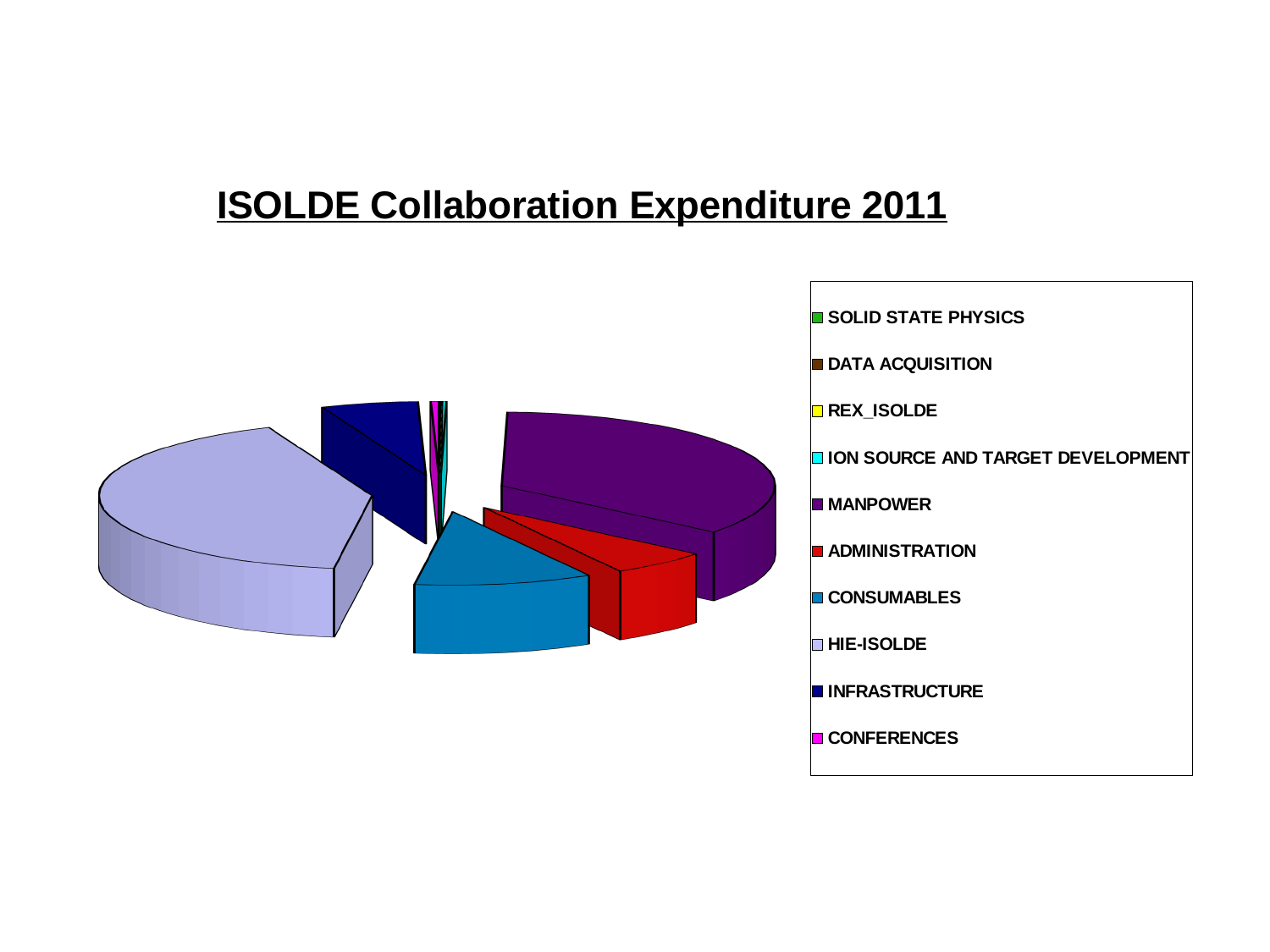
Which slice is larger, MANPOWER or ADMINISTRATION? MANPOWER Which category has the largest slice of the pie? HIE-ISOLDE What is the title of the chart? ISOLDE Collaboration Expenditure 2011 How many categories does the legend of the pie chart list? 10 Which slice is larger, INFRASTRUCTURE or CONFERENCES? INFRASTRUCTURE Which slice is larger, CONSUMABLES or ADMINISTRATION? CONSUMABLES What kind of chart is shown on the slide? pie chart What colour is the MANPOWER slice in the pie chart? purple